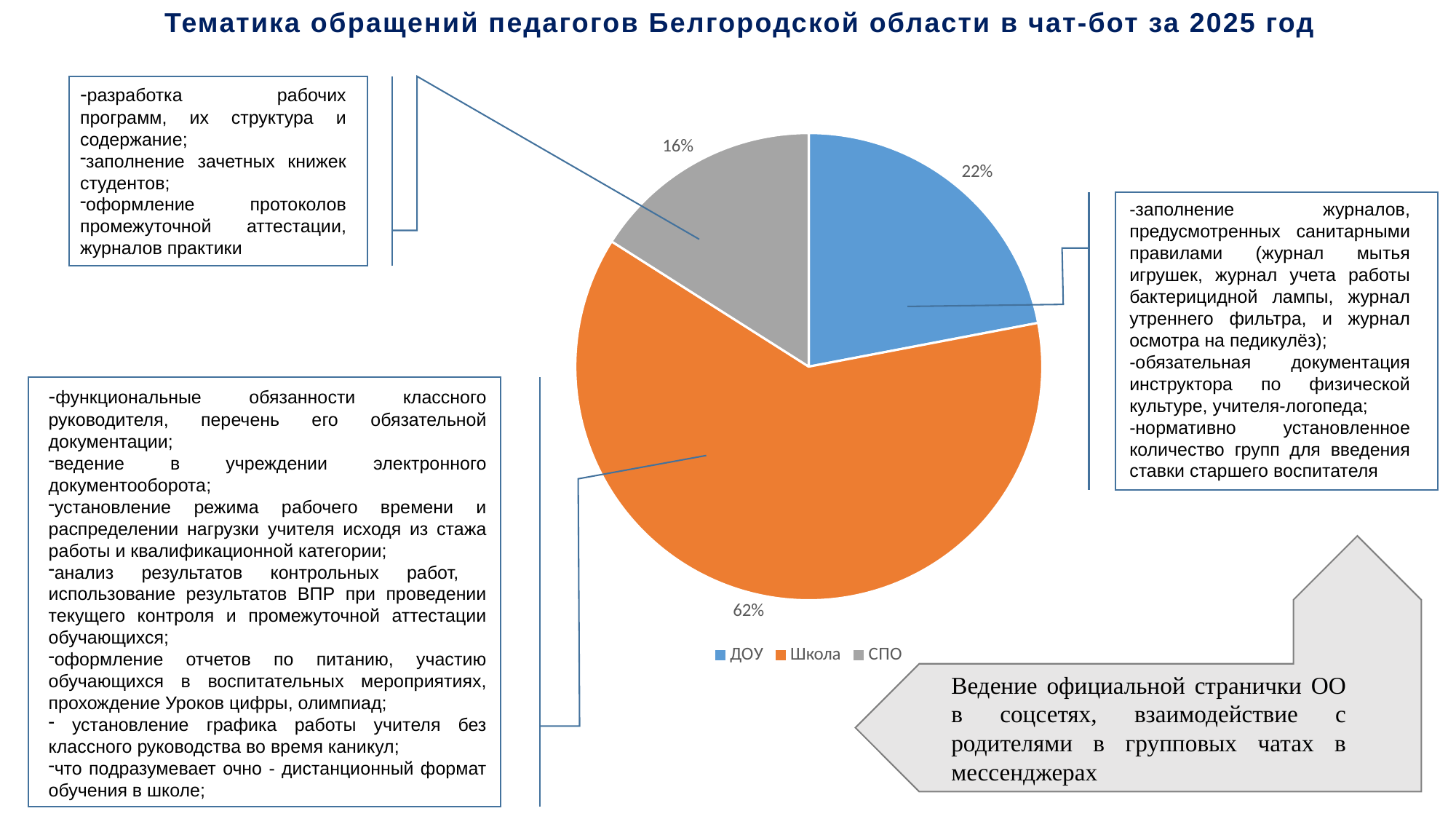
Which slice is larger, ДОУ or СПО? ДОУ What share of the pie does Школа account for? 62% What kind of chart is shown on the slide? pie chart Which category has the largest slice of the pie? Школа What share of the pie does ДОУ account for? 22% What share of the pie does СПО account for? 16% How many categories does the pie chart show? 3 What is the difference in percentage points between the Школа and ДОУ slices? 40 What colour is the Школа slice? orange What is the difference in percentage points between the ДОУ and СПО slices? 6 Which category has the smallest slice of the pie? СПО What is the title of the slide containing the chart? Тематика обращений педагогов Белгородской области в чат-бот за 2025 год